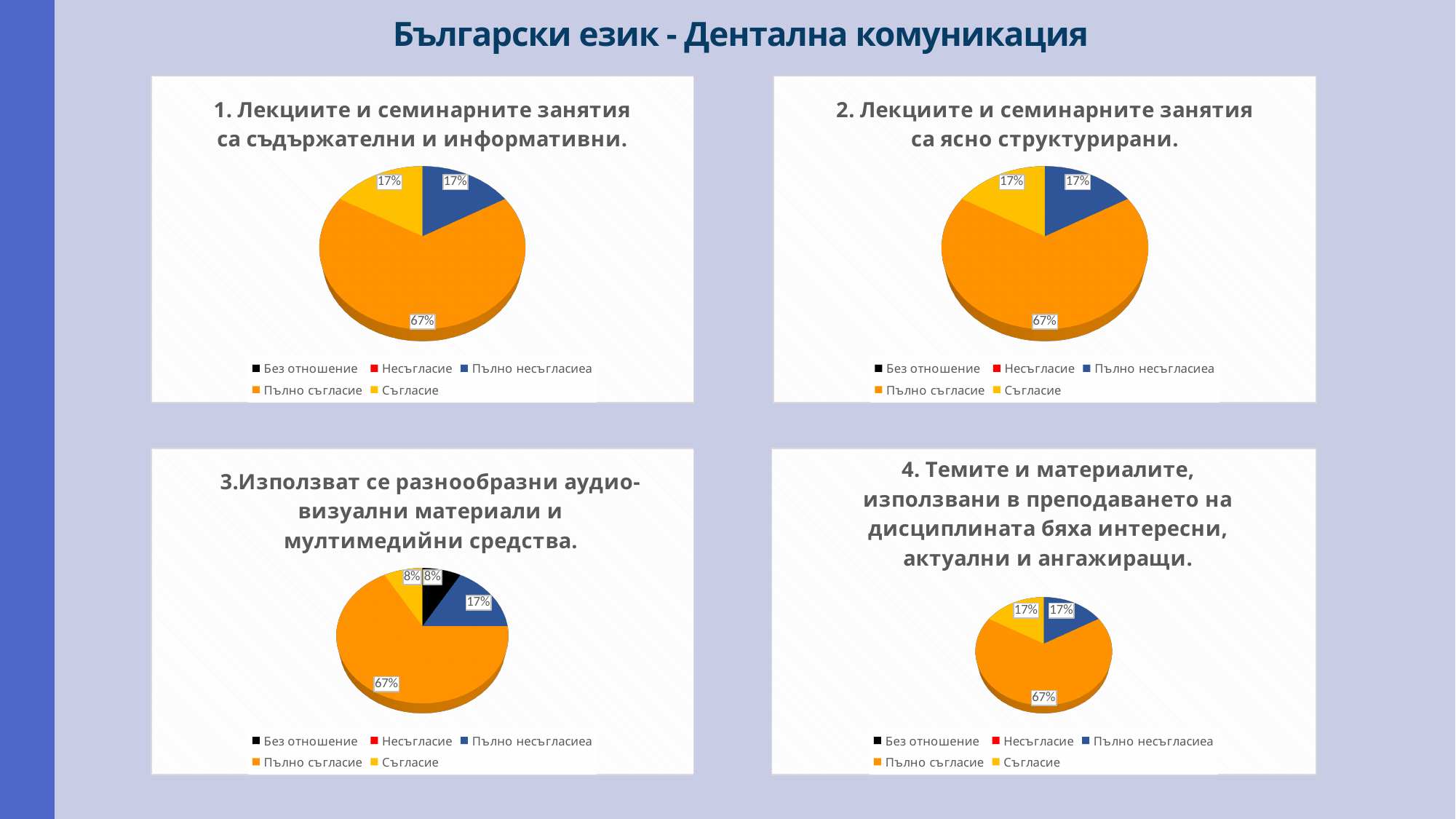
In the chart titled "4. Темите и материалите, използвани в преподаването на дисциплината бяха интересни, актуални и ангажиращи.", how many slices are shown in the pie? 3 In the chart titled "3.Използват се разнообразни аудио-визуални материали и мултимедийни средства.", what share does Без отношение have? 8% In the chart titled "1. Лекциите и семинарните занятия са съдържателни и информативни.", which category has the largest slice? Пълно съгласие In the chart titled "3.Използват се разнообразни аудио-визуални материали и мултимедийни средства.", which is larger, the Пълно несъгласиеа slice or the Без отношение slice? Пълно несъгласиеа In the chart titled "3.Използват се разнообразни аудио-визуални материали и мултимедийни средства.", what share does Съгласие have? 8% How many entries does the legend of the top-right chart list? 5 In the chart titled "2. Лекциите и семинарните занятия са ясно структурирани.", what share does Съгласие have? 17% In the chart titled "1. Лекциите и семинарните занятия са съдържателни и информативни.", what share does Пълно съгласие have? 67% In the chart titled "2. Лекциите и семинарните занятия са ясно структурирани.", what is the difference between the Пълно съгласие slice and the Пълно несъгласиеа slice? 50% In the chart titled "3.Използват се разнообразни аудио-визуални материали и мултимедийни средства.", how many slices are shown in the pie? 4 In the chart titled "4. Темите и материалите, използвани в преподаването на дисциплината бяха интересни, актуални и ангажиращи.", what share does Пълно несъгласиеа have? 17% What kind of chart is used in the top-left chart on the slide? Pie chart